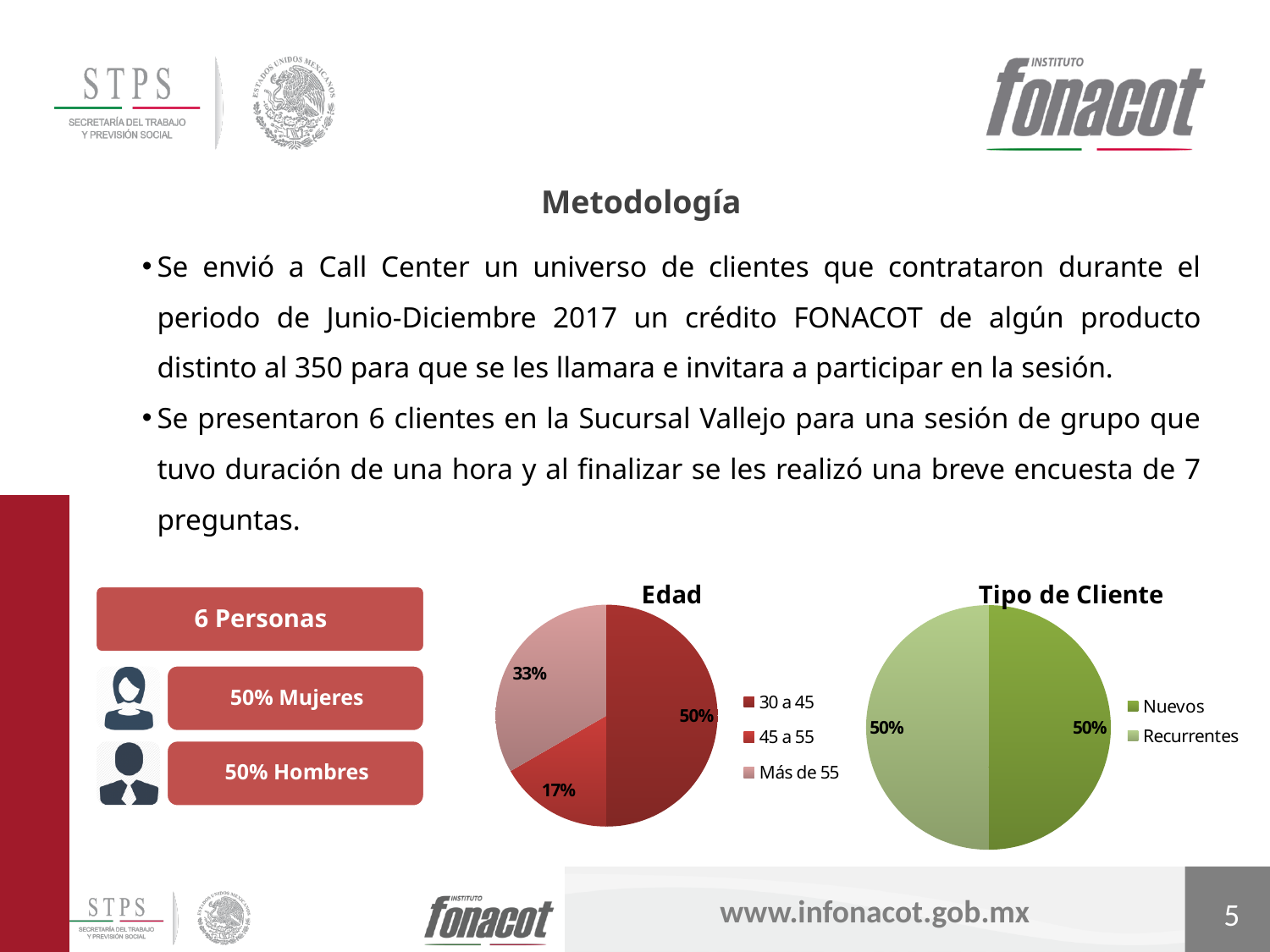
How many categories does the legend of the 'Tipo de Cliente' chart list? 2 In the 'Edad' chart, what share of the pie is the '30 a 45' slice? 50% How many slices does the 'Edad' chart have? 3 In the 'Edad' chart, what share of the pie is the '45 a 55' slice? 17% In the 'Tipo de Cliente' chart, what share of the pie is the 'Nuevos' slice? 50% In the 'Edad' chart, which age group has the largest slice? 30 a 45 In the 'Edad' chart, which is larger: the 'Más de 55' slice or the '45 a 55' slice? Más de 55 What is the title of the chart on the right side of the slide? Tipo de Cliente What kind of chart is the 'Edad' chart? Pie chart In the 'Edad' chart, what is the difference in percentage points between the '30 a 45' slice and the 'Más de 55' slice? 17% In the 'Edad' chart, which age group has the smallest slice? 45 a 55